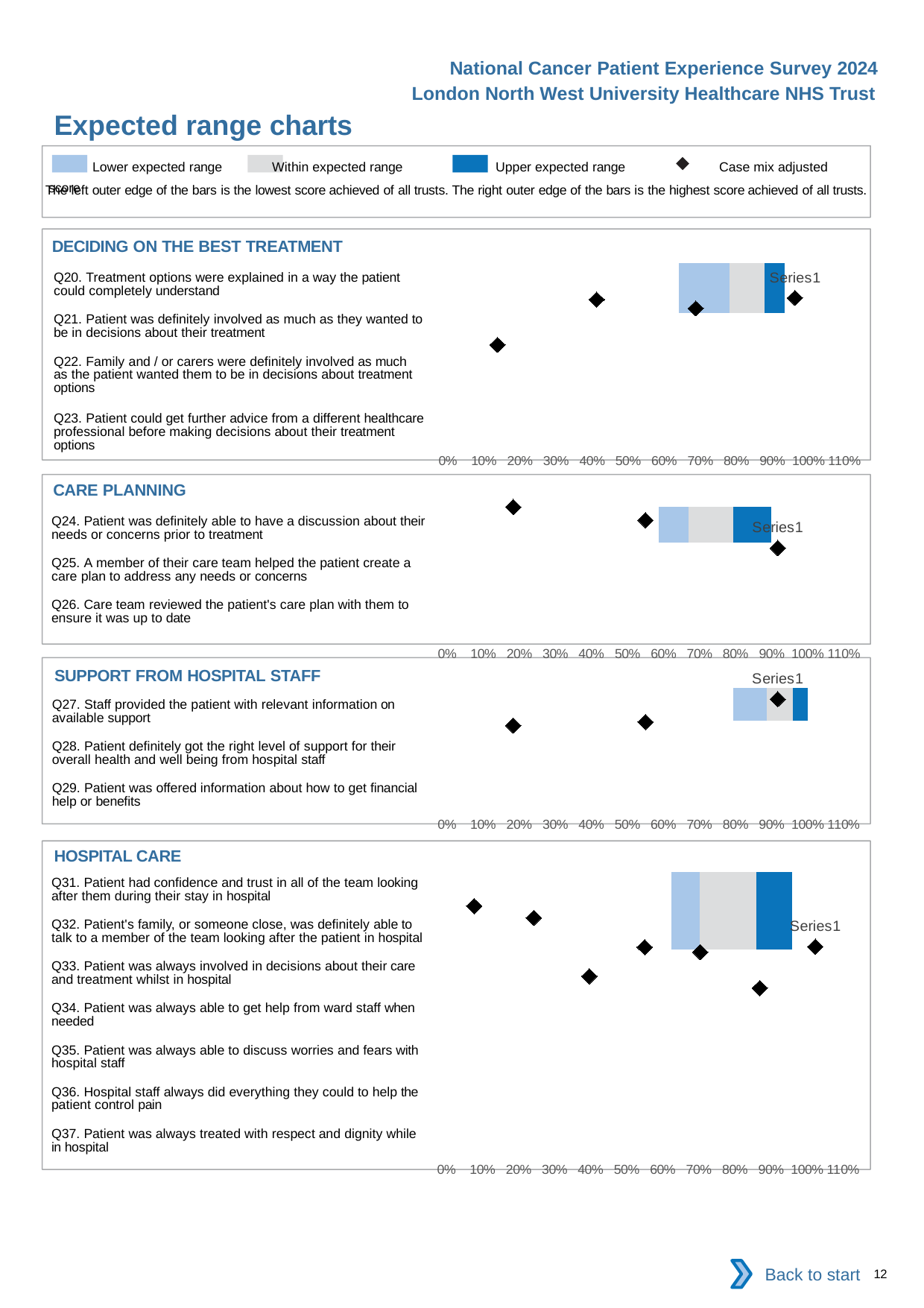
How many questions are listed in the 'SUPPORT FROM HOSPITAL STAFF' chart? 3 How many charts are shown on the slide? 4 What is the highest tick label on the x axis of the 'HOSPITAL CARE' chart? 110% How many questions are listed in the 'HOSPITAL CARE' chart? 7 How many entries does the legend at the top of the slide list? 4 Which colour in the legend represents the upper expected range? Dark blue What is the lowest tick label on the x axis of the 'CARE PLANNING' chart? 0%